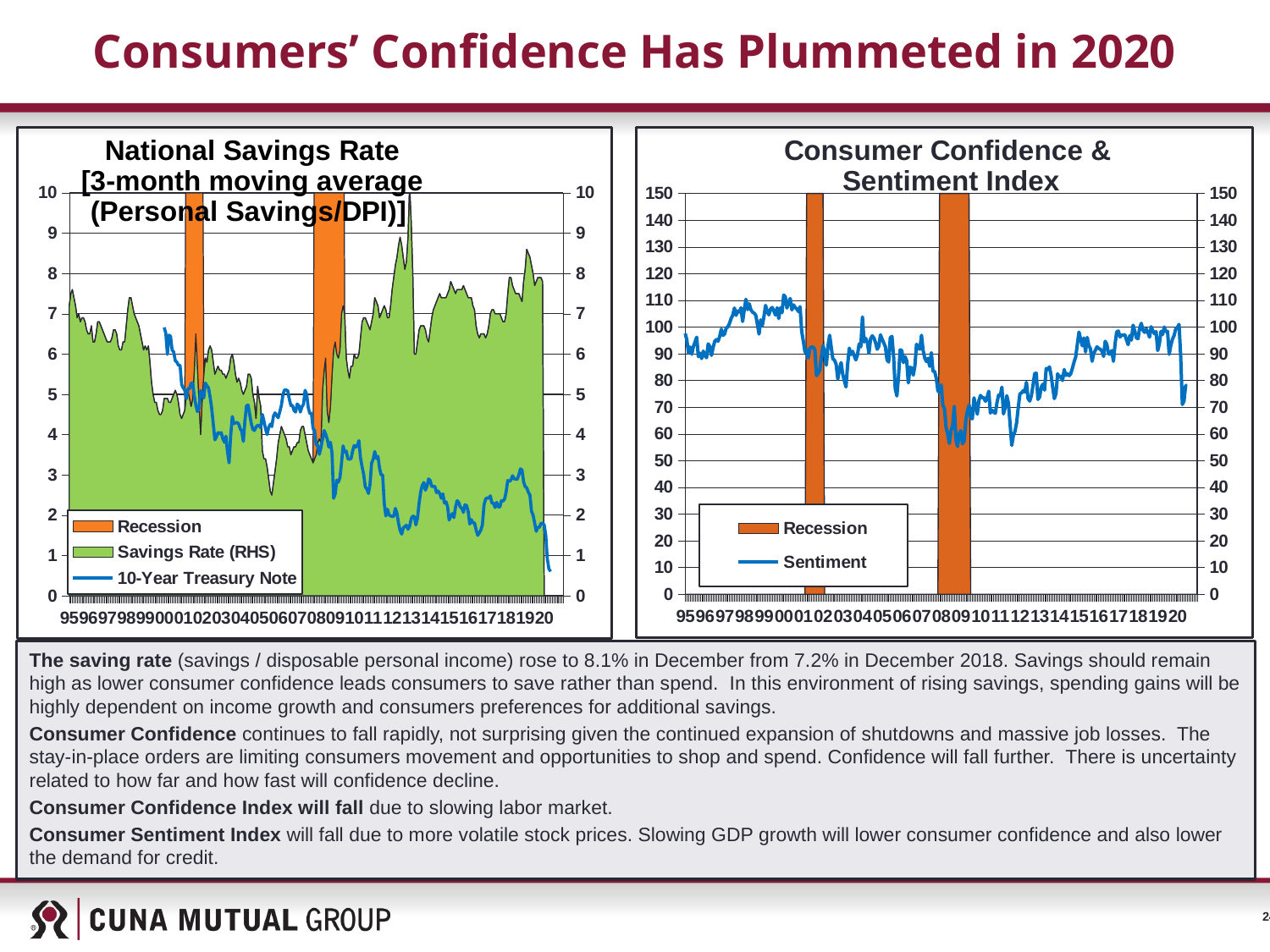
In the National Savings Rate chart, what kind of chart is used to draw the Savings Rate (RHS) series? area chart How many entries does the legend of the Consumer Confidence & Sentiment Index chart list? 2 In the Consumer Confidence & Sentiment Index chart, what kind of chart is used to draw the Sentiment series? line chart What is the title of the chart on the right side of the slide? Consumer Confidence & Sentiment Index In the National Savings Rate chart, is the 10-Year Treasury Note value at the end of 2020 greater or less than 2? less How many entries does the legend of the National Savings Rate chart list? 3 In the Consumer Confidence & Sentiment Index chart, is the Sentiment value at its low point around 2009 greater or less than 70? less In the Consumer Confidence & Sentiment Index chart, is the Sentiment value at its peak around 2000 greater or less than 100? greater In the National Savings Rate chart, which legend entry is shown in blue? 10-Year Treasury Note In the National Savings Rate chart, does the 10-Year Treasury Note generally rise or fall from 1995 to 2020? fall In the Consumer Confidence & Sentiment Index chart, does the Sentiment series generally rise or fall from 2009 to 2019? rise In the Consumer Confidence & Sentiment Index chart, how many orange recession bands are shaded? 2